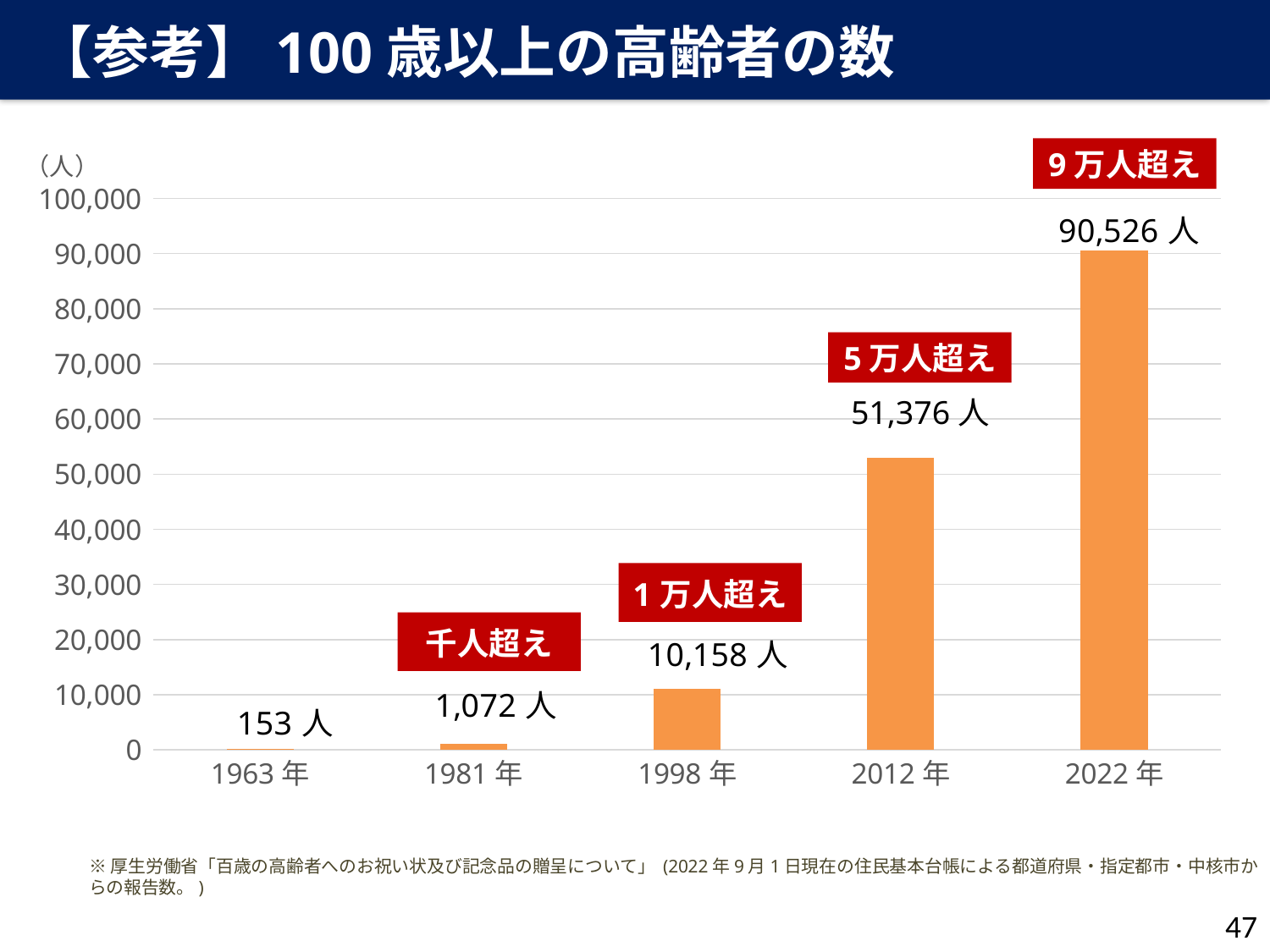
What is the value shown for 2012年? 51,376 人 Which is larger, the value for 1981年 or the value for 1998年? 1998年 Do the values rise or fall from 1963年 to 2022年? Rise Which year has the highest value? 2022年 What is the difference between the values for 1998年 and 1981年? 9,086 人 How many years are shown on the x axis? 5 What is the value shown for 1998年? 10,158 人 Which year has the lowest value? 1963年 What is the value shown for 1963年? 153 人 What kind of chart is shown on the slide? Bar chart What is the value shown for 2022年? 90,526 人 What is the difference between the values for 2022年 and 2012年? 39,150 人